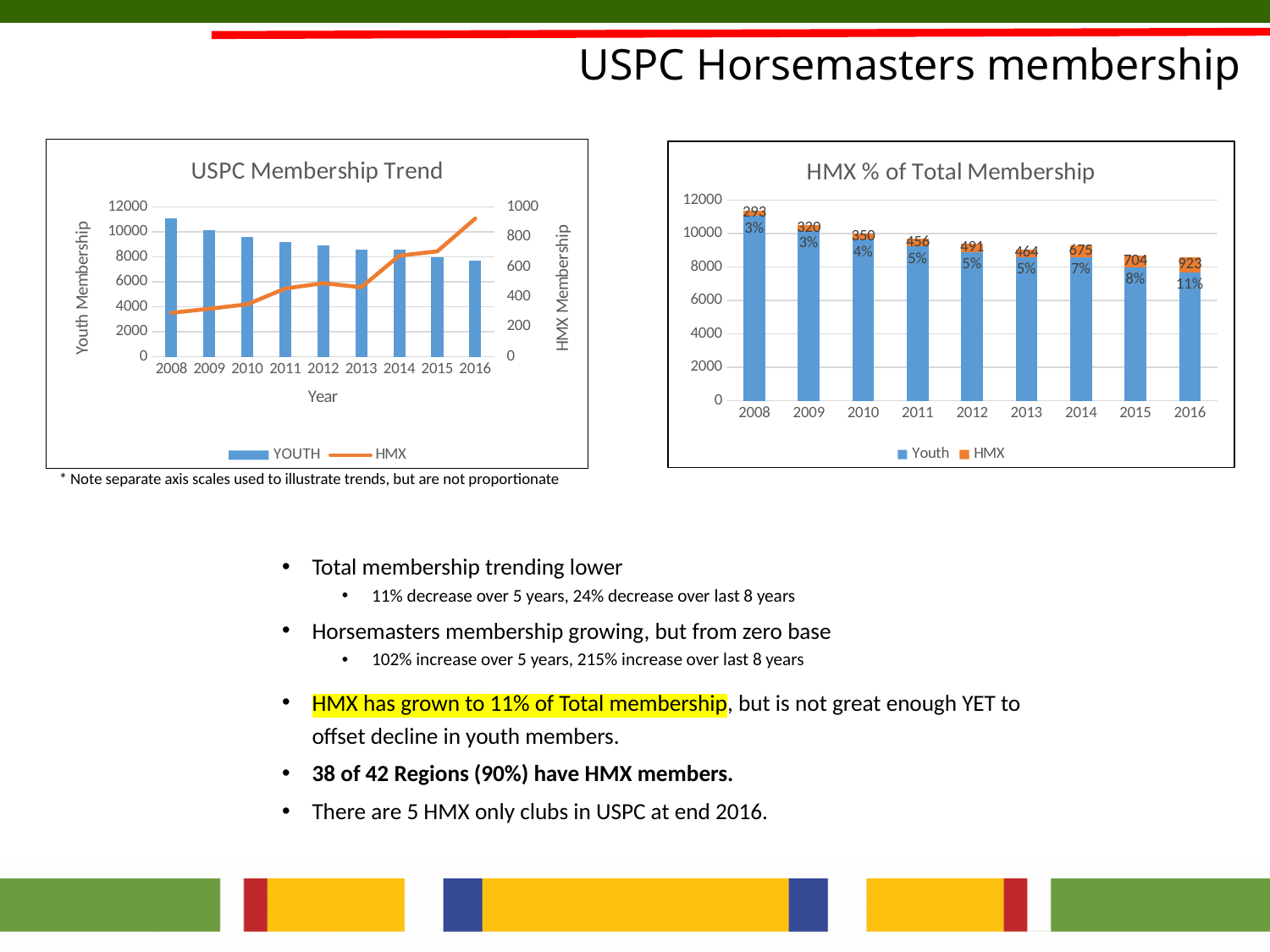
In the 'USPC Membership Trend' chart, what kind of chart is used to show the YOUTH series? bar chart In the 'HMX % of Total Membership' chart, what is the difference between the HMX values for 2016 and 2008? 630 In the 'HMX % of Total Membership' chart, which year has the lowest HMX value? 2008 In the 'HMX % of Total Membership' chart, which year has the highest HMX value? 2016 How many years are shown on the x axis of the 'USPC Membership Trend' chart? 9 In the 'HMX % of Total Membership' chart, what is the HMX value for 2016? 923 In the 'USPC Membership Trend' chart, do the YOUTH bars rise or fall from 2008 to 2016? fall In the 'HMX % of Total Membership' chart, which year has the larger HMX value, 2013 or 2014? 2014 In the 'USPC Membership Trend' chart, is the YOUTH value for 2008 greater or less than 10000? greater In the 'HMX % of Total Membership' chart, what is the HMX value for 2008? 293 How many series does the legend of the 'HMX % of Total Membership' chart list? 2 In the 'HMX % of Total Membership' chart, what percentage of total membership is HMX in 2016? 11%